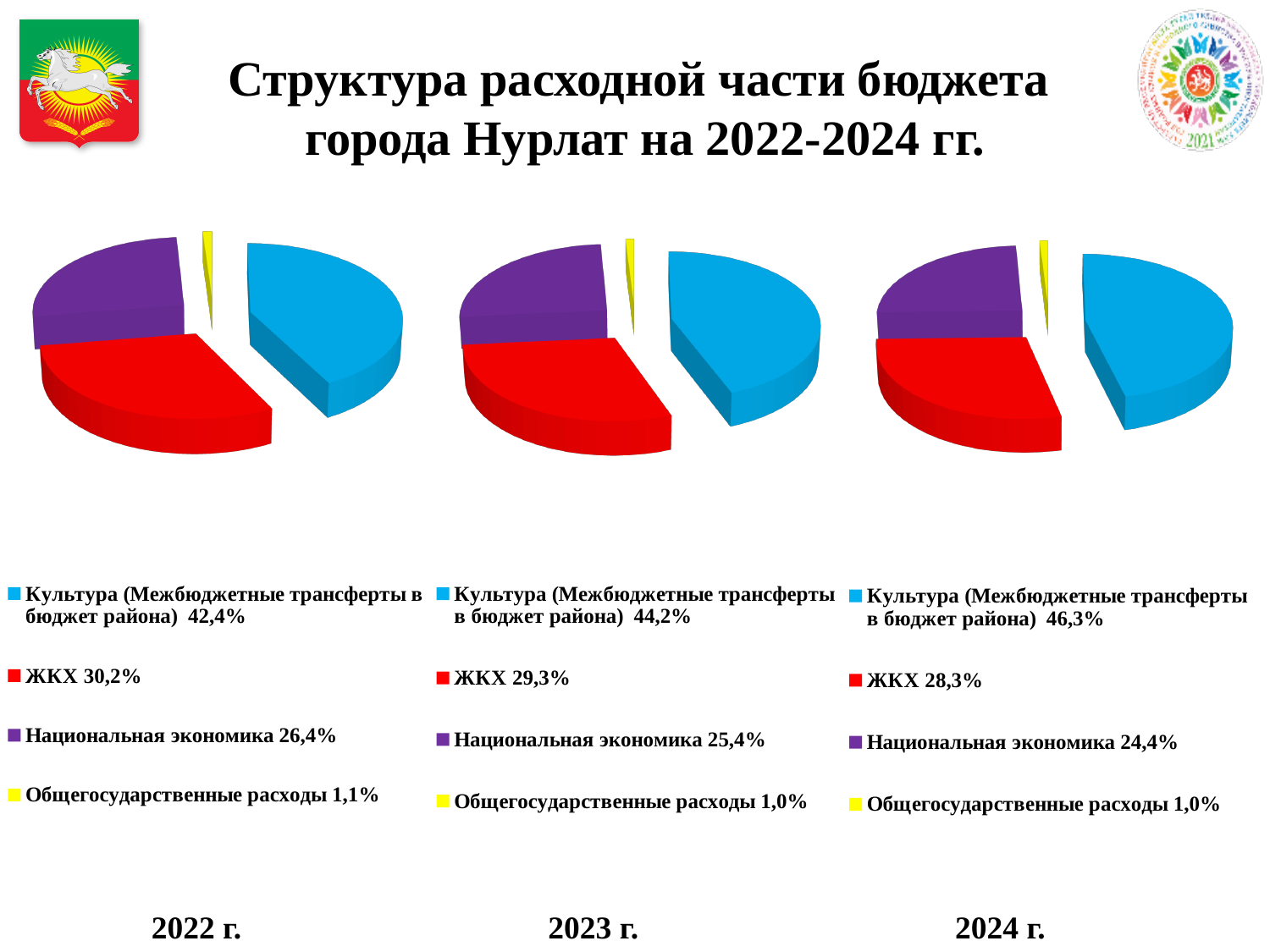
In the 2022 pie chart, what is the difference in percentage points between ЖКХ and Национальная экономика? 3,8 In the 2024 pie chart, what is the difference in percentage points between Культура and ЖКХ? 18,0 In the 2022 pie chart, what share does Культура (Межбюджетные трансферты в бюджет района) have? 42,4% In the 2024 pie chart, which category has the largest share? Культура (Межбюджетные трансферты в бюджет района) What type of chart is used on this slide? Pie chart In the 2023 pie chart, which category has the smallest share? Общегосударственные расходы Does the share of Культура (Межбюджетные трансферты в бюджет района) rise or fall from 2022 to 2024? Rise In the 2024 pie chart, what is the value for Национальная экономика? 24,4% In the 2023 pie chart, which is larger: ЖКХ or Национальная экономика? ЖКХ How many categories does each pie chart on the slide show? 4 In the 2022 pie chart, what is the value for Общегосударственные расходы? 1,1% In the 2023 pie chart, what is the value for ЖКХ? 29,3%